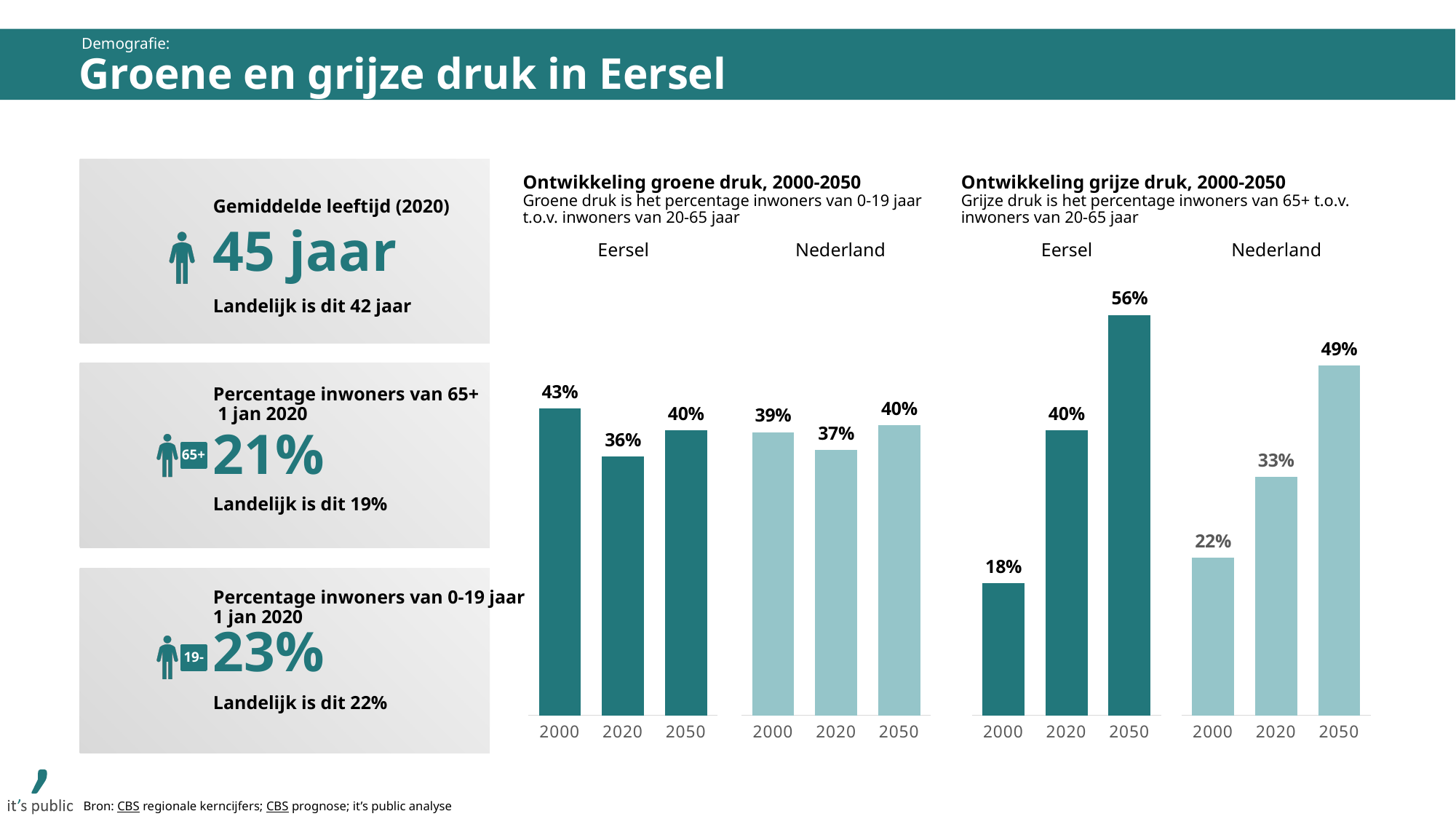
In the chart 'Ontwikkeling grijze druk, 2000-2050', what is the difference between the Eersel value in 2050 and the Eersel value in 2000? 38 percentage points In the chart 'Ontwikkeling grijze druk, 2000-2050', what is the value for Nederland in 2000? 22% In the chart 'Ontwikkeling grijze druk, 2000-2050', which is larger in 2050: Eersel or Nederland? Eersel In the chart 'Ontwikkeling groene druk, 2000-2050', what is the value for Eersel in 2000? 43% In the chart 'Ontwikkeling groene druk, 2000-2050', what is the difference between the Eersel value in 2000 and the Nederland value in 2000? 4 percentage points In the chart 'Ontwikkeling groene druk, 2000-2050', which year has the highest value for Eersel? 2000 In the chart 'Ontwikkeling groene druk, 2000-2050', what is the value for Nederland in 2020? 37% How many bars are shown in the chart 'Ontwikkeling grijze druk, 2000-2050'? 6 What kind of chart is 'Ontwikkeling groene druk, 2000-2050'? bar chart In the chart 'Ontwikkeling grijze druk, 2000-2050', do the values for Nederland rise or fall from 2000 to 2050? rise In the chart 'Ontwikkeling grijze druk, 2000-2050', what is the value for Eersel in 2050? 56% In the chart 'Ontwikkeling grijze druk, 2000-2050', which year has the lowest value for Eersel? 2000